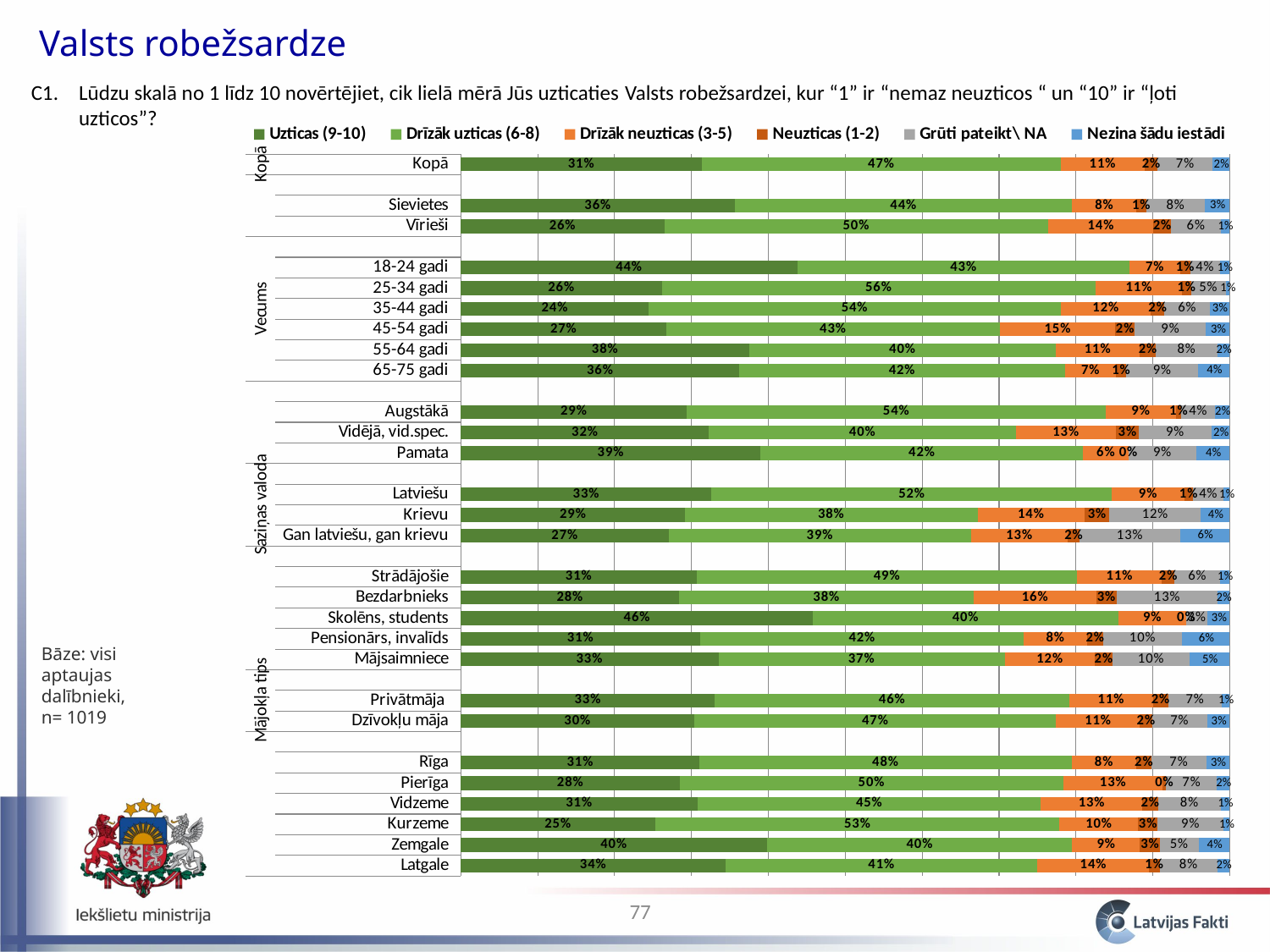
What is the difference between the 'Uzticas (9-10)' values for Sievietes and Vīrieši? 10% What is the value of 'Uzticas (9-10)' for Kopā? 31% What is the value of 'Nezina šādu iestādi' for Gan latviešu, gan krievu? 6% Which category has the highest 'Uzticas (9-10)' value? Skolēns, students What is the value of 'Drīzāk uzticas (6-8)' for 25-34 gadi? 56% What is the value of 'Drīzāk neuzticas (3-5)' for Latgale? 14% What is the base (n) stated on the slide for the survey? n= 1019 Which has a larger 'Drīzāk uzticas (6-8)' value, Kurzeme or Zemgale? Kurzeme What kind of chart is shown on the slide? Stacked bar chart How many series does the legend list? 6 How many categories (rows) are plotted in the chart? 28 Which category has the lowest 'Uzticas (9-10)' value? 35-44 gadi